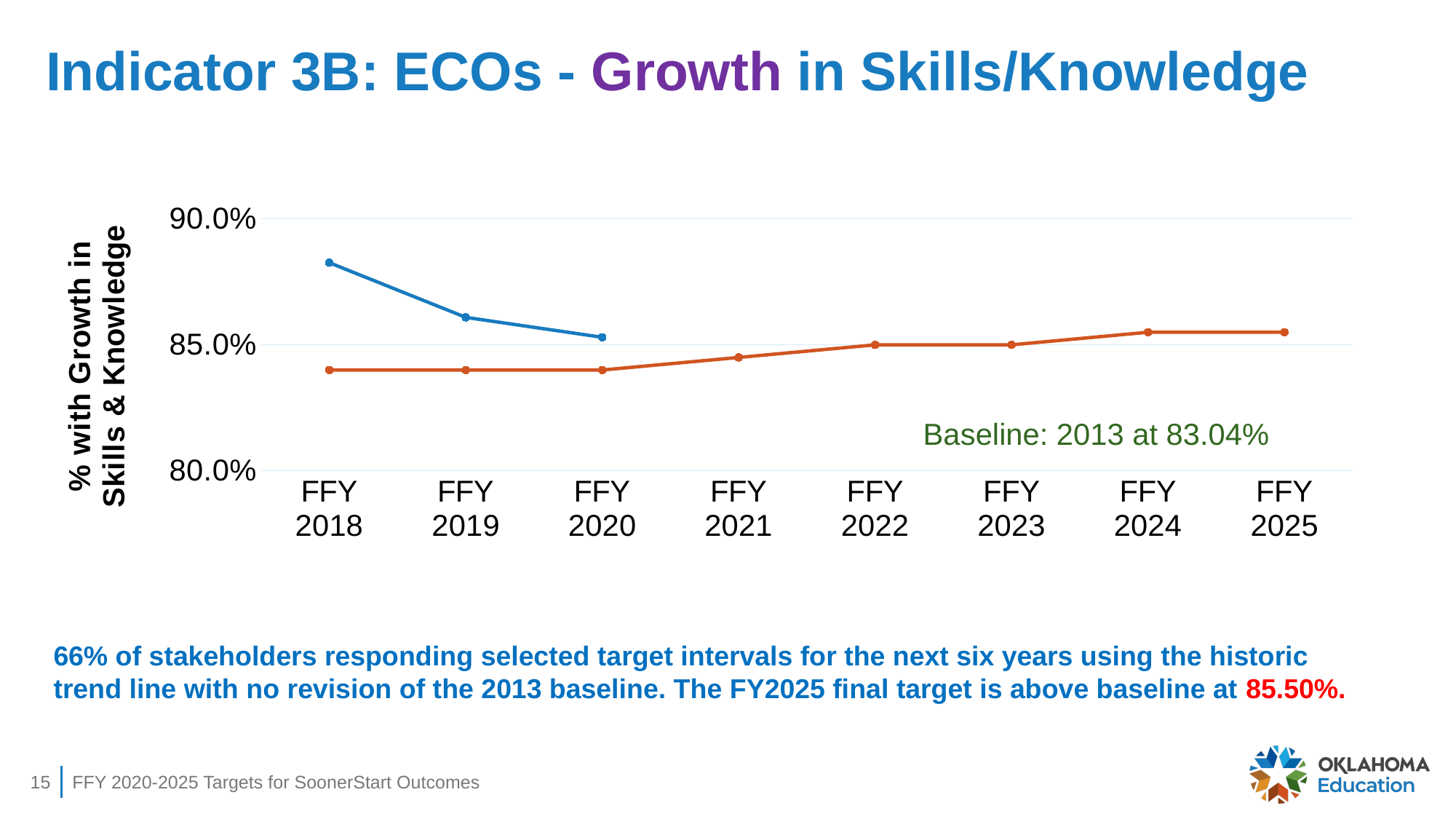
Does the orange line rise or fall from FFY 2020 to FFY 2025? rise Is the value of the blue line for FFY 2018 greater or less than 85.0%? greater Is the value of the orange line for FFY 2018 greater or less than 85.0%? less What kind of chart is shown on the slide? line chart How many data points does the blue line have? 3 How many fiscal years are shown on the x axis of the chart? 8 What is the title of the y axis of the chart? % with Growth in Skills & Knowledge Does the blue line rise or fall from FFY 2018 to FFY 2020? fall In which fiscal year does the blue line reach its highest value? FFY 2018 At FFY 2018, which line has the higher value, the blue line or the orange line? the blue line Is the value of the blue line for FFY 2018 greater or less than 90.0%? less